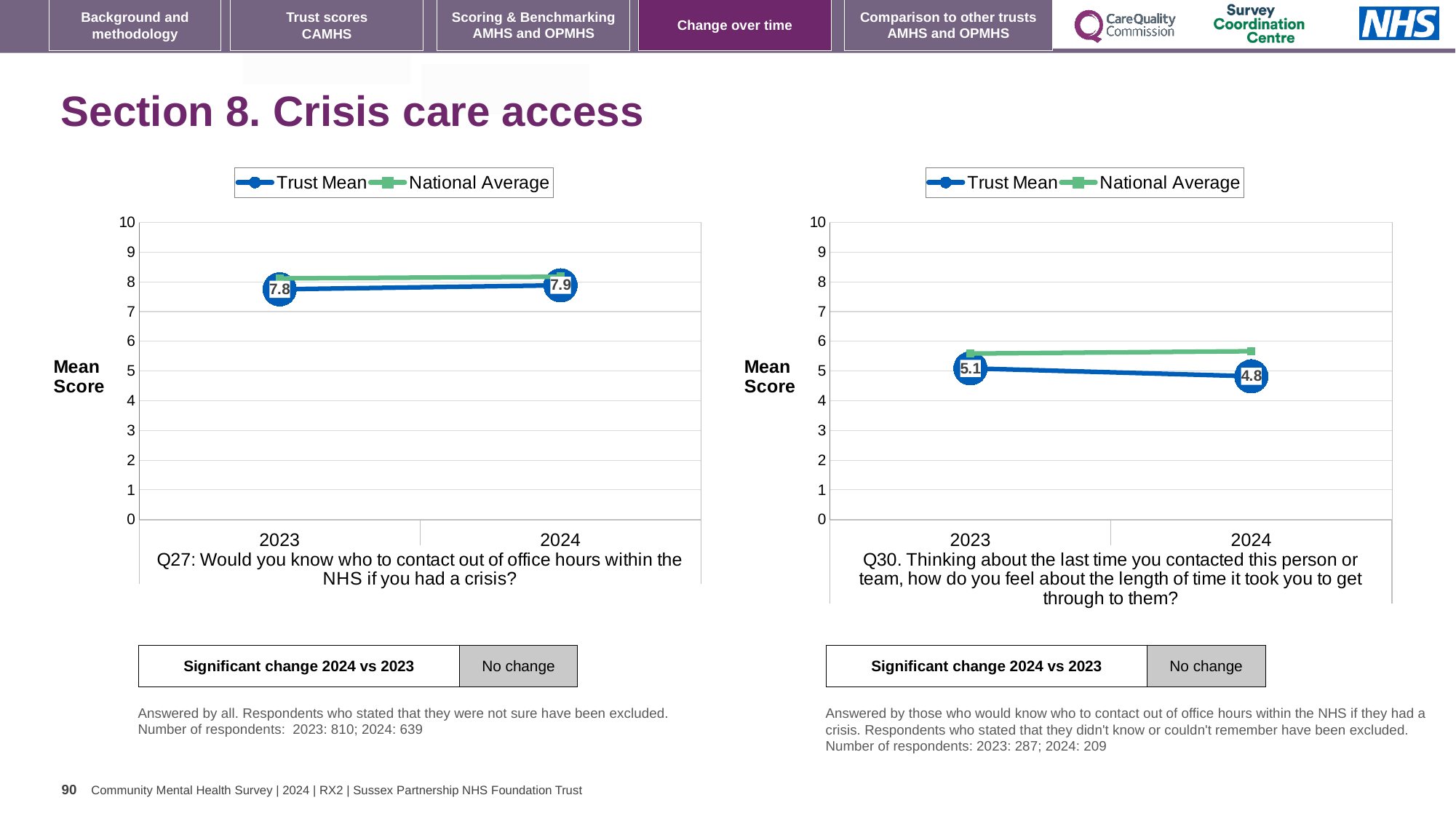
On the right chart (Q30), does the Trust Mean rise or fall from 2023 to 2024? fall On the right chart (Q30), is the National Average for 2024 greater or less than 5? greater On the right chart (Q30), what is the Trust Mean score for 2023? 5.1 On the right chart (Q30), what is the Trust Mean score for 2024? 4.8 On the left chart (Q27), does the Trust Mean rise or fall from 2023 to 2024? rise On the left chart (Q27), what is the Trust Mean score for 2024? 7.9 On the left chart (Q27), which series is higher in 2023, Trust Mean or National Average? National Average How many series does the legend of the left chart (Q27) list? 2 What type of chart is used for Q30 on the right? line chart On the left chart (Q27), what is the Trust Mean score for 2023? 7.8 On the right chart (Q30), by how much did the Trust Mean change from 2023 to 2024? 0.3 How many years are plotted on the x axis of the right chart (Q30)? 2